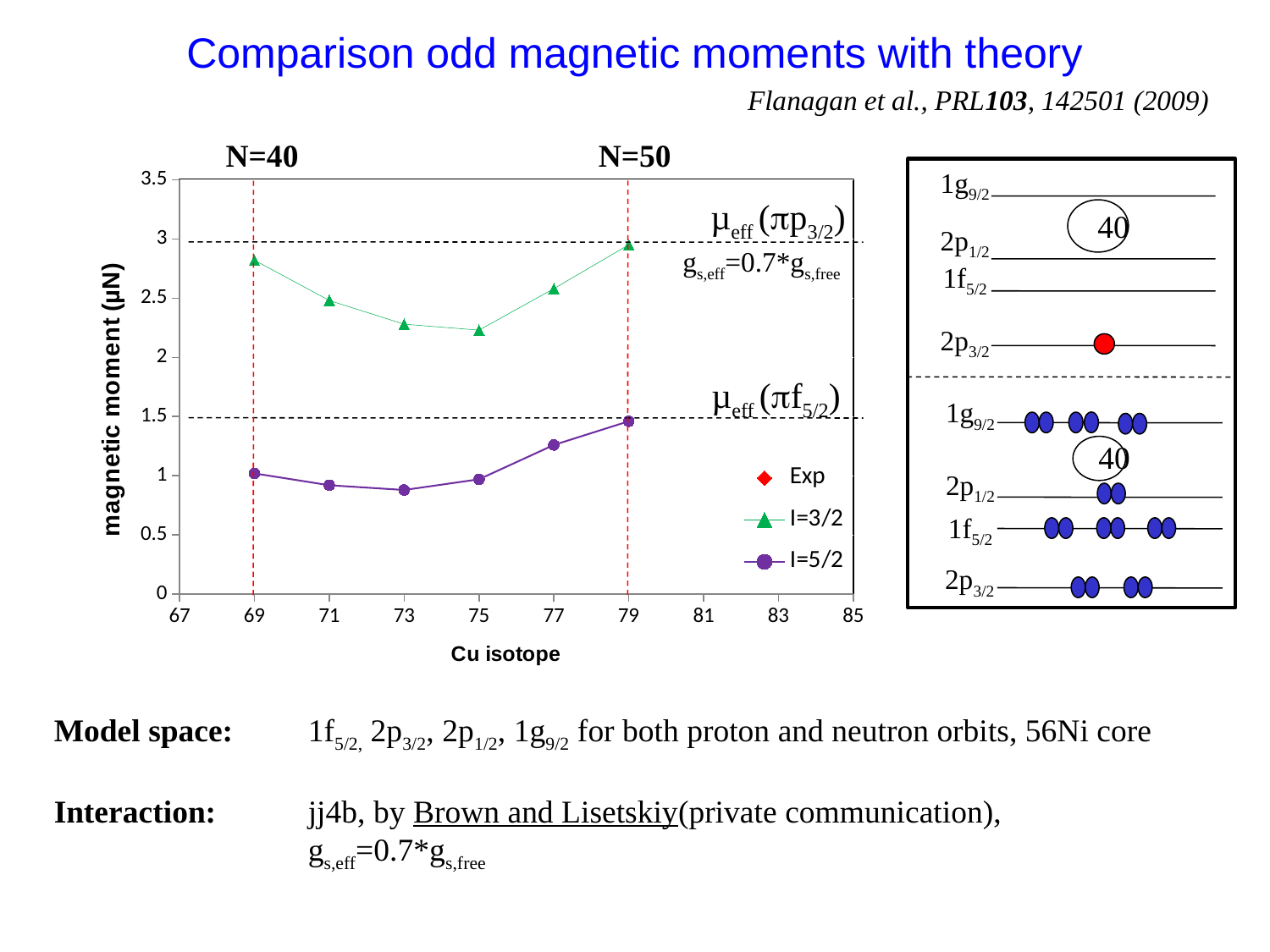
How many data points are plotted for the I=3/2 series? 6 What kind of chart is shown on the slide? line chart Does the I=5/2 magnetic moment rise or fall from Cu isotope 73 to 79? rise Is the I=3/2 value for Cu isotope 73 greater or less than 2.5? less Is the I=5/2 value for Cu isotope 73 greater or less than 1? less What is the label of the y axis of the chart? magnetic moment (μN) For which Cu isotope is the I=5/2 magnetic moment highest? 79 At Cu isotope 75, which series has the larger magnetic moment, I=3/2 or I=5/2? I=3/2 Does the I=3/2 magnetic moment rise or fall from Cu isotope 69 to 75? fall Is the I=5/2 value for Cu isotope 79 greater or less than 1? greater How many series does the legend of the chart list? 3